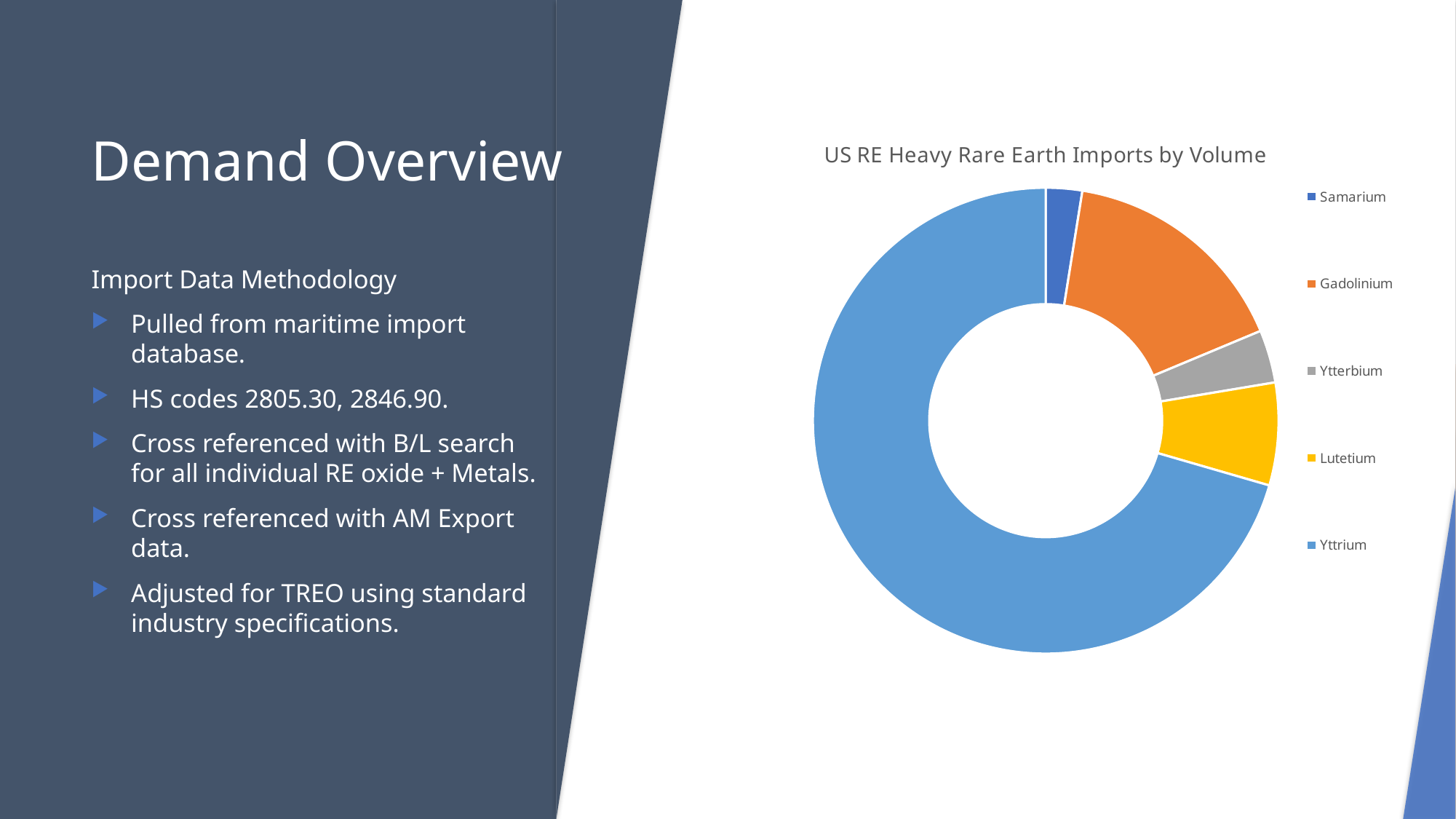
What type of chart is shown on the slide? Doughnut (pie) chart What is the title of the chart? US RE Heavy Rare Earth Imports by Volume Which category is shown in orange on the chart? Gadolinium Which has a larger share, Samarium or Lutetium? Lutetium Which has a larger share, Gadolinium or Lutetium? Gadolinium Which category is listed first in the legend? Samarium Is Yttrium's share of the chart greater or less than 50%? greater Which category has the smallest share of the chart? Samarium Which has a larger share, Yttrium or Gadolinium? Yttrium How many categories does the chart's legend list? 5 Which category has the largest share of the chart? Yttrium